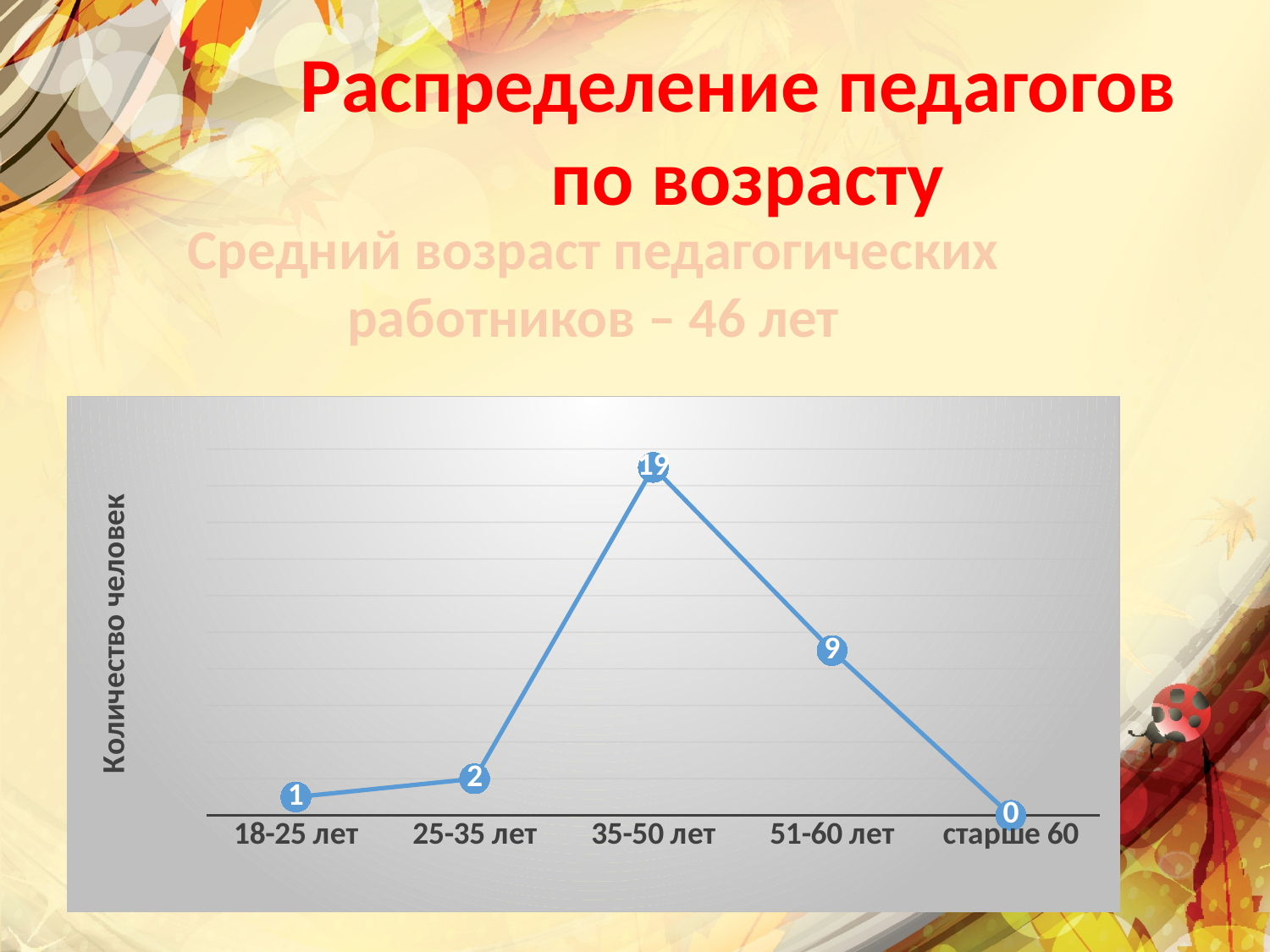
How many age categories are plotted on the x axis? 5 What is the difference between the values for 35-50 лет and 51-60 лет? 10 Which age group has the highest number of people? 35-50 лет How many people are in the 35-50 лет age group? 19 Do the values rise or fall from 35-50 лет to старше 60? fall What is the value for the 18-25 лет category? 1 What kind of chart is shown on the slide? line chart What is the value for the старше 60 category? 0 Which age group has the lowest number of people? старше 60 Which is larger, the value for 25-35 лет or the value for 51-60 лет? 51-60 лет What is the label of the vertical axis? Количество человек What is the value for the 51-60 лет category? 9